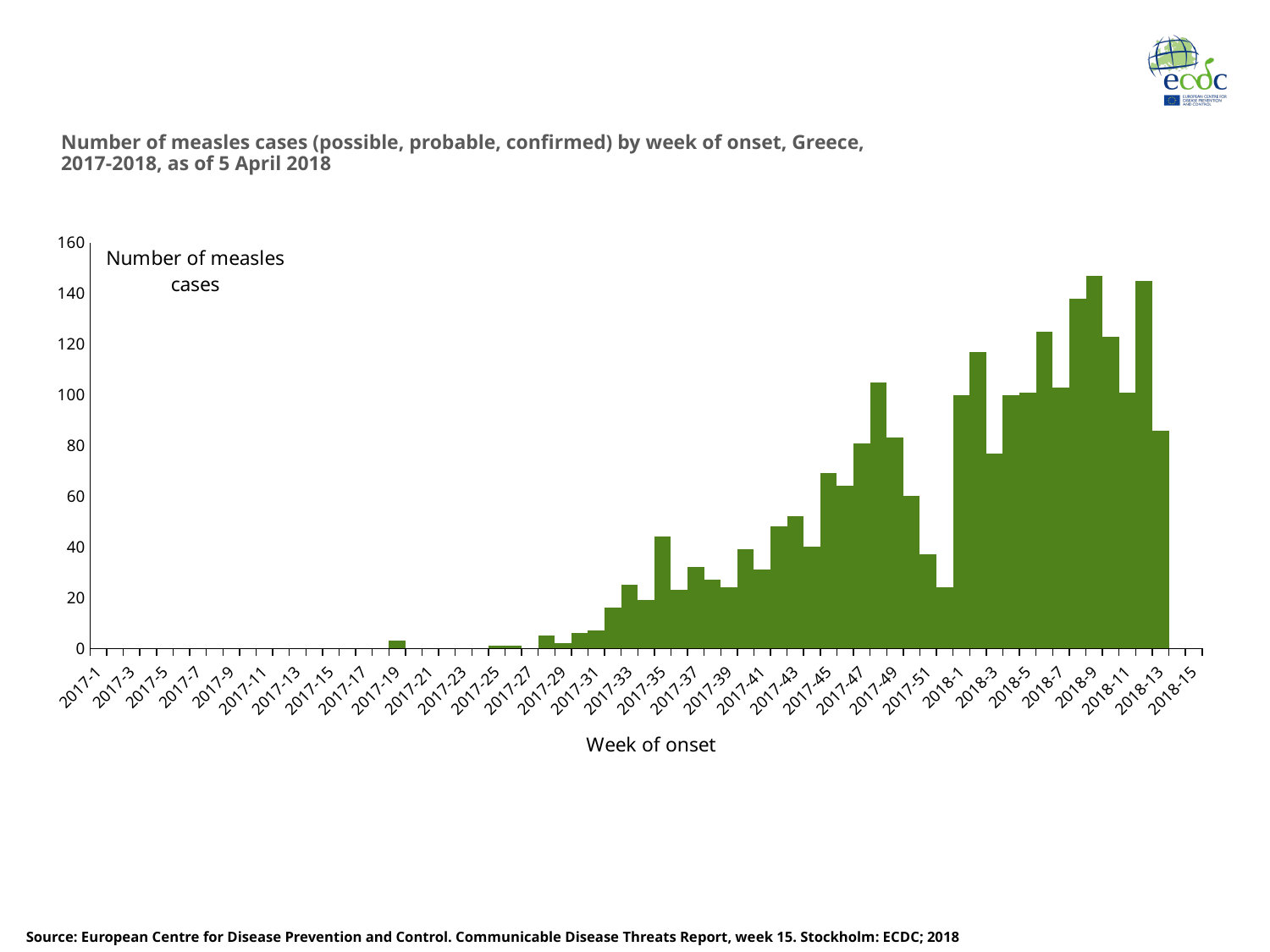
Is the value for week 2018-3 greater or less than 80? less Is the value for week 2018-9 greater or less than 140? greater What is the title of the x axis? Week of onset Is the value for week 2017-51 greater or less than 40? less What kind of chart is shown on the slide? bar chart Which week has more measles cases, 2018-9 or 2018-3? 2018-9 Which week has more measles cases, 2017-49 or 2017-51? 2017-49 Overall, do the number of measles cases rise or fall from 2017-1 to 2018-13? rise What label is shown for the y axis? Number of measles cases